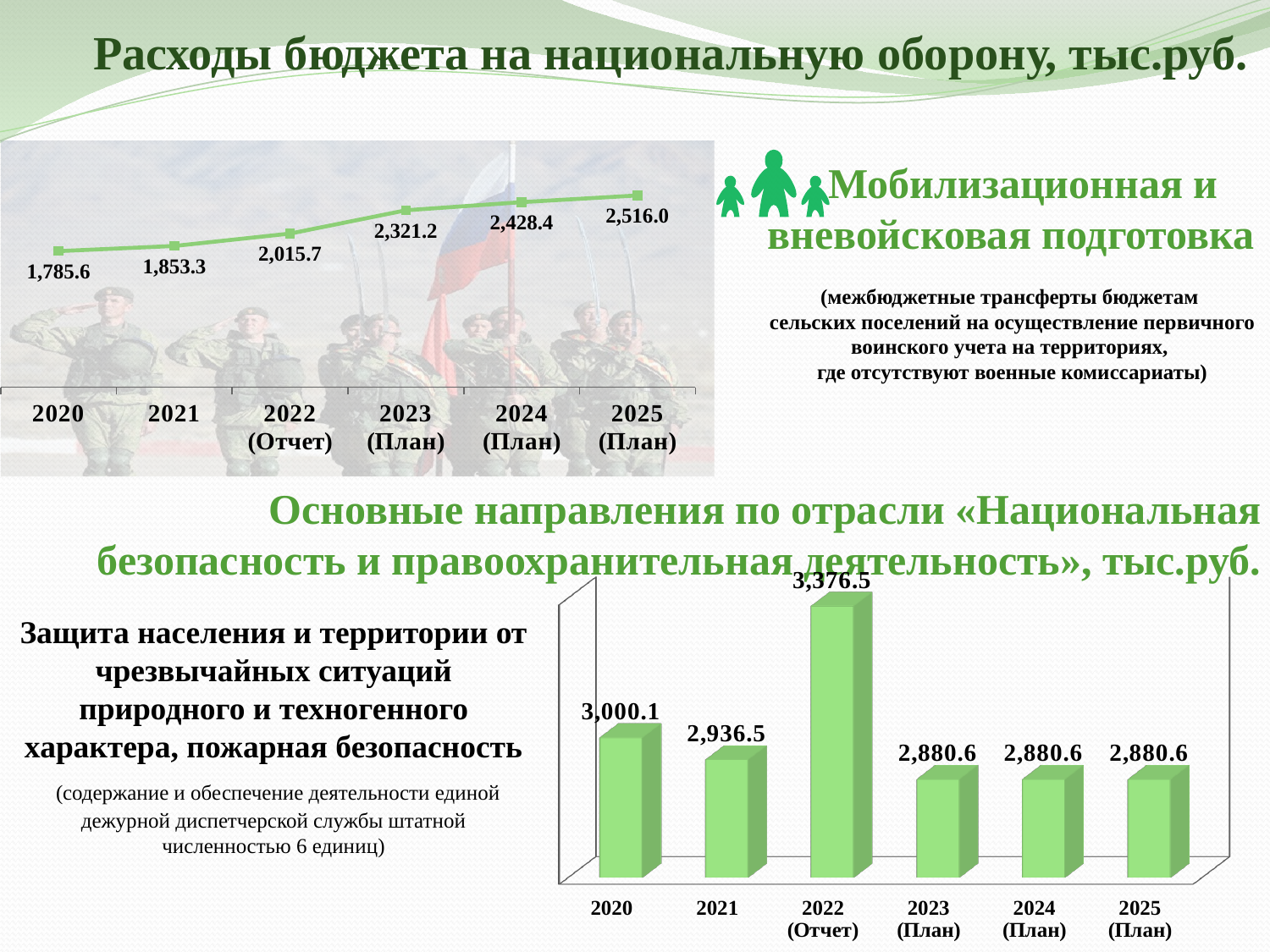
How many years are shown on the x axis of the bottom bar chart? 6 In the top line chart, which year has the lowest value? 2020 In the top line chart, do the values rise or fall from 2020 to 2025? rise In the bottom bar chart, which year has the highest value? 2022 (Отчет) In the top line chart, what is the value for 2025 (План)? 2,516.0 What kind of chart is the top chart on the slide? line chart In the bottom bar chart, what is the difference between the values for 2022 (Отчет) and 2023 (План)? 495.9 In the top line chart, what is the difference between the values for 2023 (План) and 2022 (Отчет)? 305.5 In the bottom bar chart, what is the value for 2021? 2,936.5 In the bottom bar chart, what is the value for 2022 (Отчет)? 3,376.5 In the bottom bar chart, which is larger: the value for 2020 or the value for 2021? 2020 In the top line chart (Расходы бюджета на национальную оборону), what is the value for 2020? 1,785.6